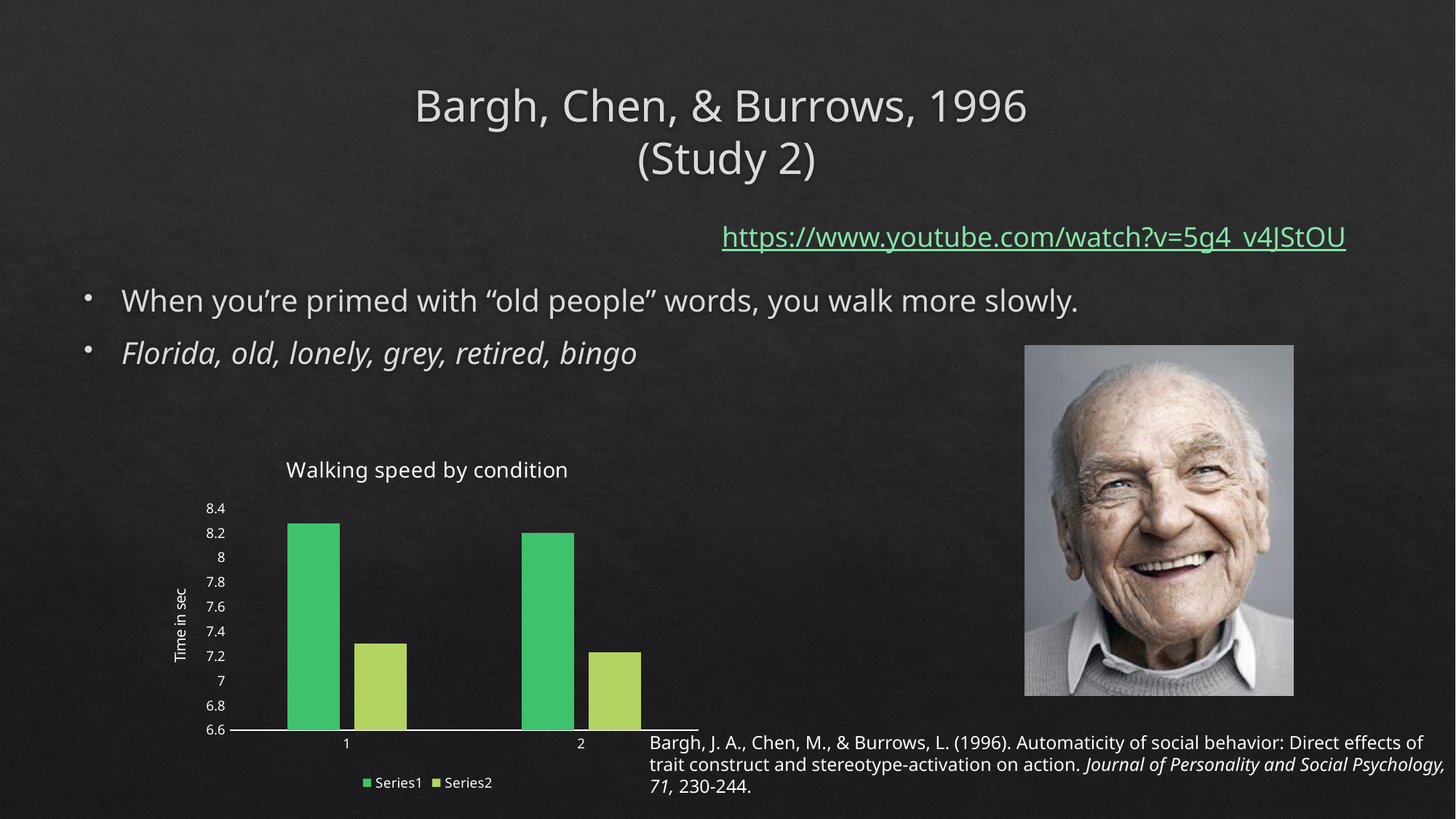
What type of chart is shown on the slide? bar chart What is the title of the chart? Walking speed by condition How many series does the chart's legend list? 2 Is the value for Series2 in category 1 greater or less than 7? greater Is the value for Series1 in category 1 greater or less than 8? greater Is the value for Series2 in category 1 greater or less than 7.4? less In category 2, which series has the larger value, Series1 or Series2? Series1 What is the label on the vertical axis of the chart? Time in sec In category 1, which series has the larger value, Series1 or Series2? Series1 How many categories are shown on the x axis of the chart? 2